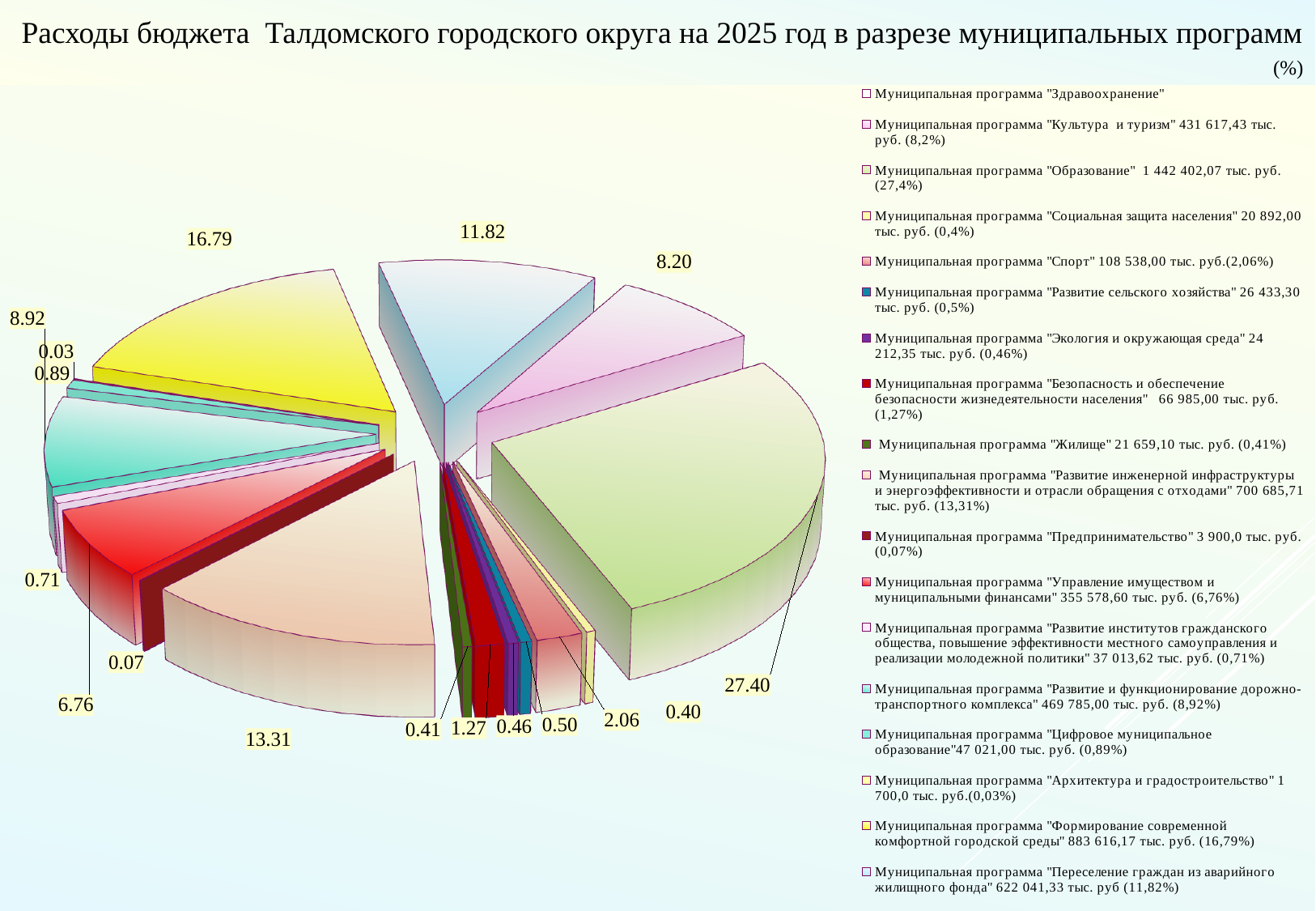
Which municipal programme has the largest share of the 2025 budget expenditure? Муниципальная программа "Образование" How many entries does the legend list? 18 What share (%) is shown for the programme "Развитие инженерной инфраструктуры и энергоэффективности и отрасли обращения с отходами"? 13.31 Which is larger: the share for "Развитие и функционирование дорожно-транспортного комплекса" (8.92) or for "Культура и туризм" (8.20)? Развитие и функционирование дорожно-транспортного комплекса What share (%) is shown for the programme "Формирование современной комфортной городской среды"? 16.79 What is the difference in percentage points between the largest slice (27.40) and the slice labelled 16.79? 10.61 What is the title of the chart on the slide? Расходы бюджета Талдомского городского округа на 2025 год в разрезе муниципальных программ (%) What share (%) is shown for the programme "Управление имуществом и муниципальными финансами"? 6.76 What share (%) is shown for the programme "Переселение граждан из аварийного жилищного фонда"? 11.82 What type of chart is shown on the slide? Pie chart What percentage is shown for the slice labelled 27.40, the largest slice of the pie? 27.40 What is the smallest value printed on the pie chart? 0.03